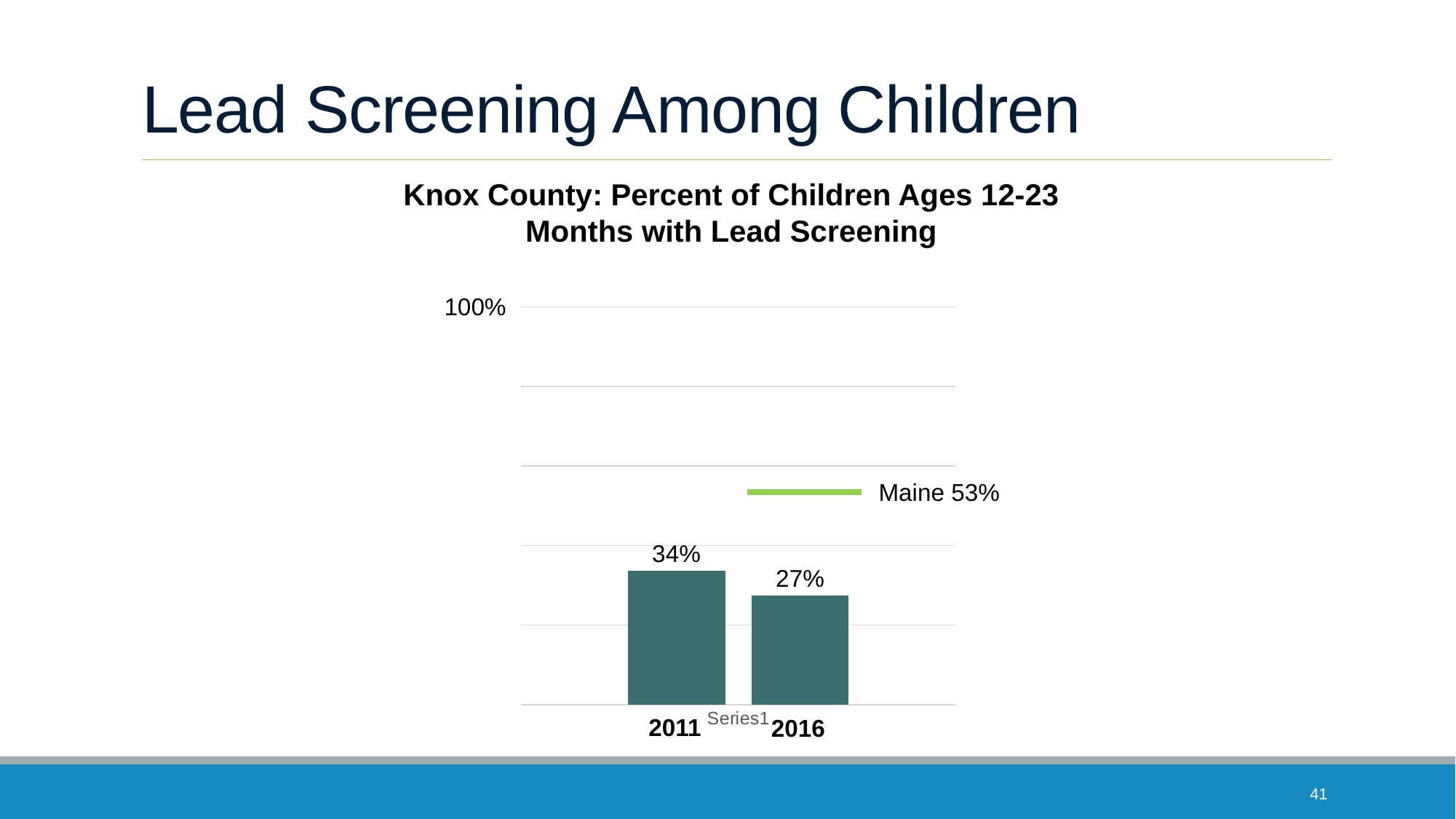
What kind of chart is this? bar chart What is the title of the chart? Knox County: Percent of Children Ages 12-23 Months with Lead Screening How many years are plotted as bars? 2 What is the value for 2011? 34% What is the difference between the Maine value and the 2016 Knox County value? 26% Is the value for 2011 greater or less than 100%? less What is the Maine value shown by the reference line? 53% Which year has the lowest value? 2016 What is the difference between the 2011 and 2016 values? 7% Which year has the higher value, 2011 or 2016? 2011 What is the value for 2016? 27% Do the values rise or fall from 2011 to 2016? fall